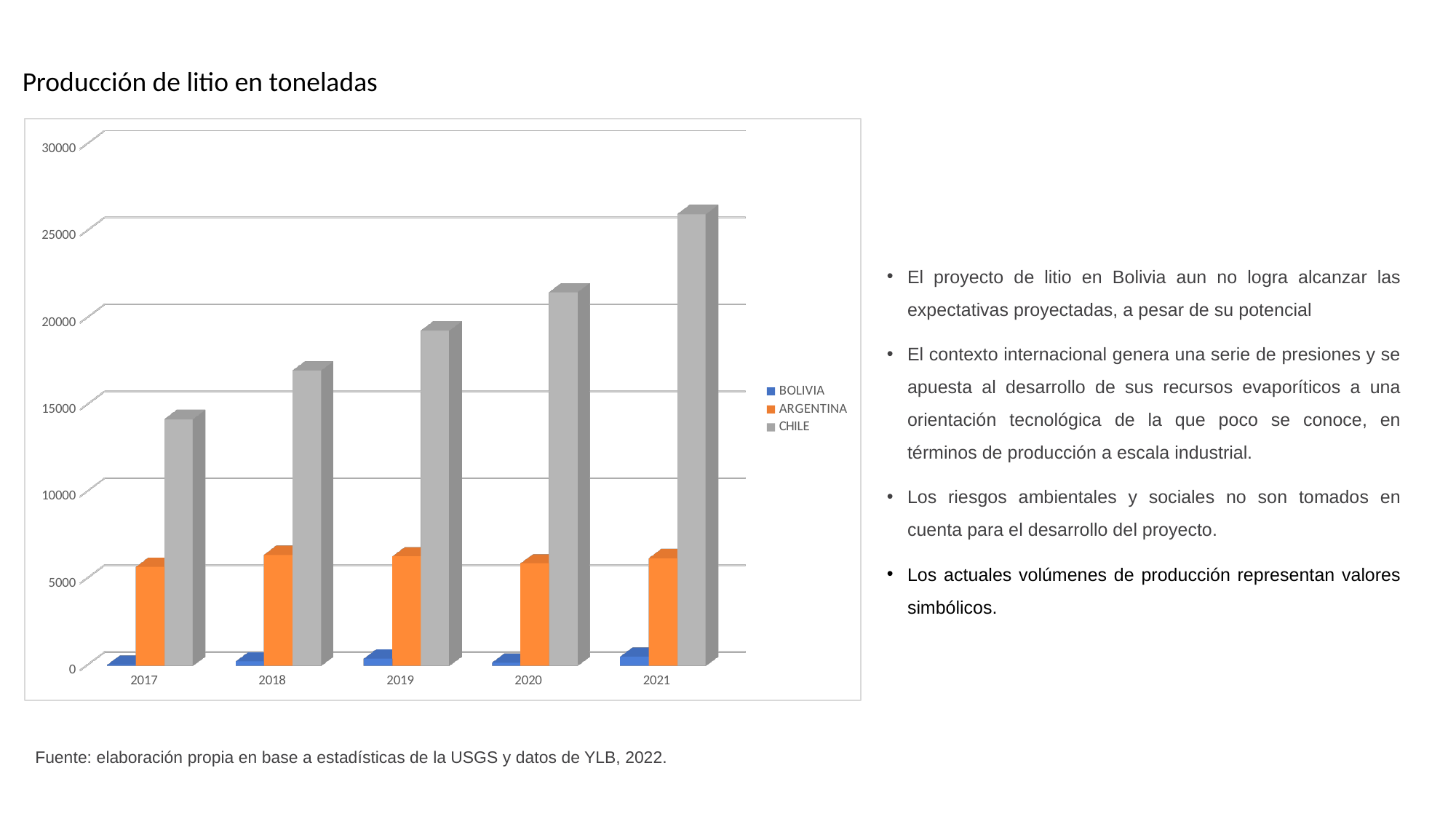
In which year is the value for CHILE highest? 2021 How many years are shown on the x axis? 5 Is the value for ARGENTINA in 2018 greater or less than 10000? less What is the title of the chart? Producción de litio en toneladas What kind of chart is shown on the slide? Bar chart Which country has the highest production in every year shown? CHILE Is the value for CHILE in 2018 greater or less than 20000? less Does the value for CHILE rise or fall from 2017 to 2021? Rise Which country has the lowest production in every year shown? BOLIVIA How many series does the legend list? 3 Which is larger in 2021, the value for CHILE or the value for ARGENTINA? CHILE Is the value for CHILE in 2021 greater or less than 20000? greater